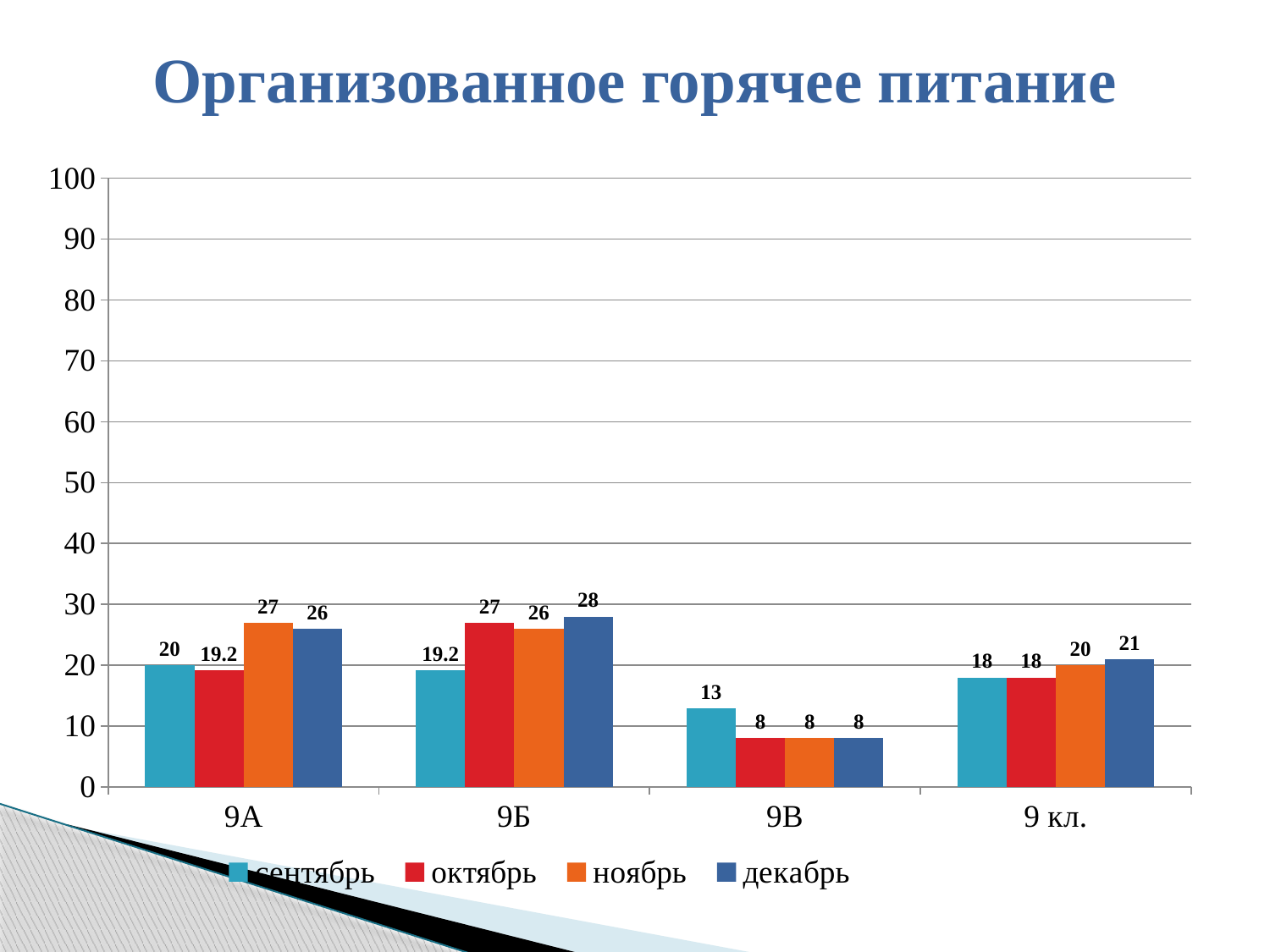
What is the value for 9 кл. in ноябрь? 20 How many series does the legend list? 4 Which category has the lowest value in сентябрь? 9В How many categories are shown on the x axis? 4 Which is larger: the октябрь value for 9Б or the октябрь value for 9 кл.? 9Б What is the value for 9Б in декабрь? 28 What is the difference between the ноябрь and сентябрь values for 9А? 7 Which category has the highest value in декабрь? 9Б What is the value for 9В in октябрь? 8 What kind of chart is shown on the slide? bar chart Is the value for 9В in сентябрь greater or less than 10? greater What is the value for 9А in сентябрь? 20